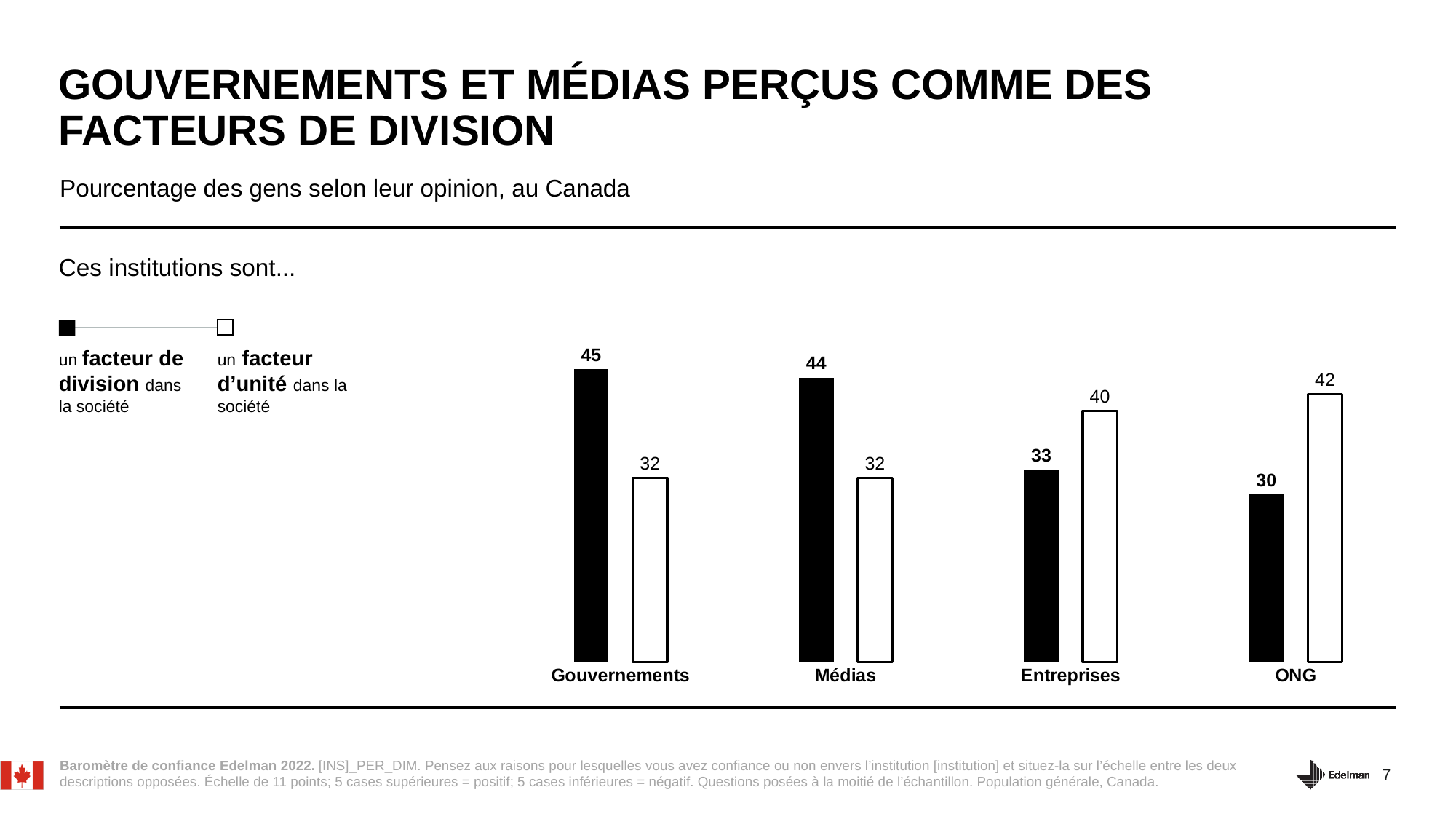
Which institution has the lowest value for 'facteur de division'? ONG What percentage of people see ONG as a factor of unity in society? 42 How many institutions are shown on the chart? 4 What percentage of people see Gouvernements as a factor of division in society? 45 Which institution has the highest value for 'facteur d'unité'? ONG What is the difference between the division and unity values for Gouvernements? 13 How many series does the legend list? 2 For Entreprises, which is larger: the 'facteur de division' value or the 'facteur d'unité' value? facteur d'unité What kind of chart is shown on the slide? Bar chart Which colour represents 'un facteur de division dans la société' in the legend? Black Which institution has the highest value for 'facteur de division'? Gouvernements What is the value for Entreprises as a factor of division? 33